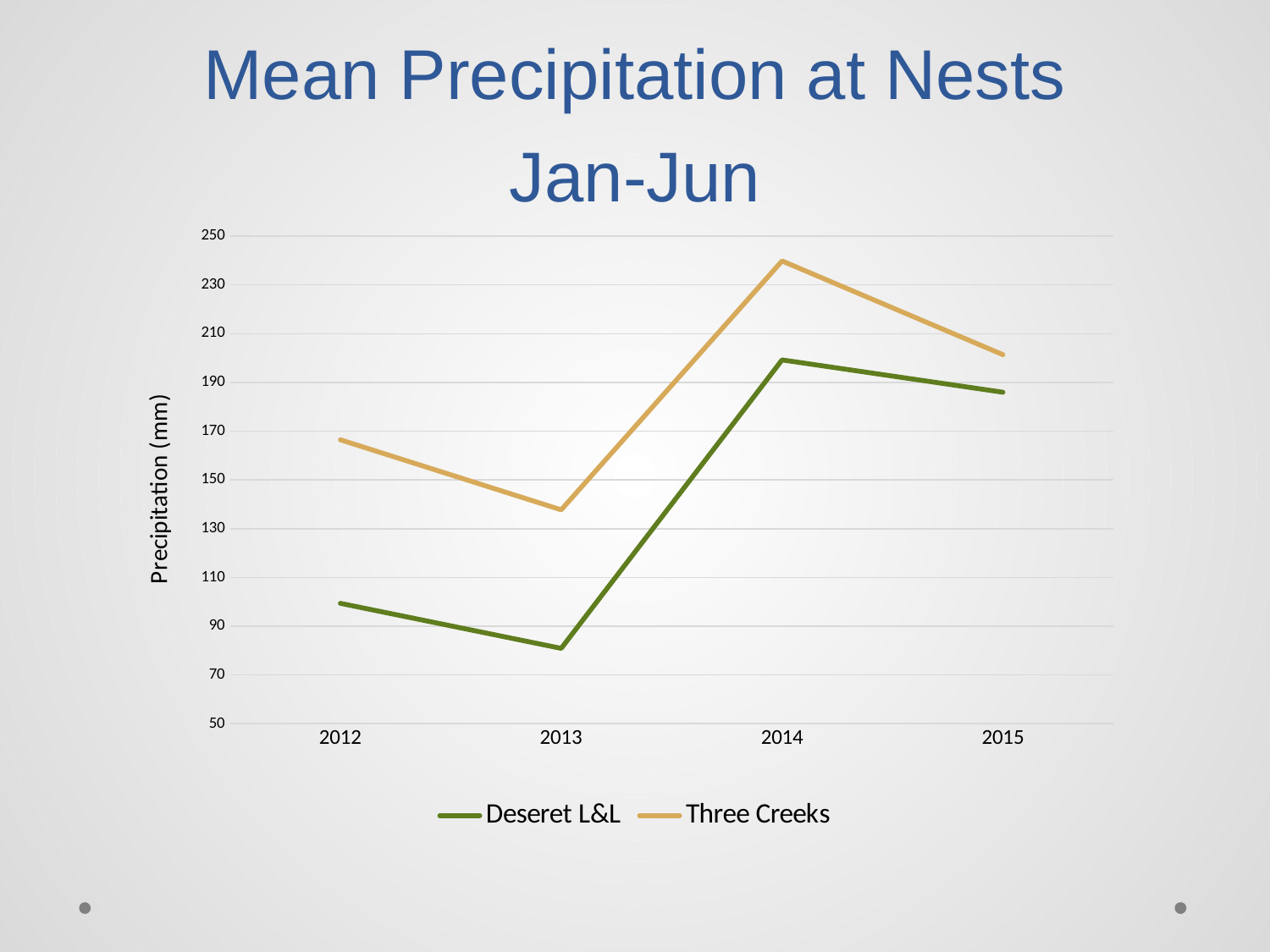
Is the value for Deseret L&L in 2013 greater or less than 90? less How many years are plotted along the x axis? 4 How many series does the legend list? 2 What kind of chart is shown on the slide? Line chart In which year does the Three Creeks series reach its lowest value? 2013 In which year does the Three Creeks series reach its highest value? 2014 Does the Deseret L&L series rise or fall from 2013 to 2014? rise Is the value for Deseret L&L in 2015 greater or less than 170? greater In 2014, which series has the larger value, Deseret L&L or Three Creeks? Three Creeks Is the value for Three Creeks in 2013 greater or less than 150? less In which year does the Deseret L&L series reach its lowest value? 2013